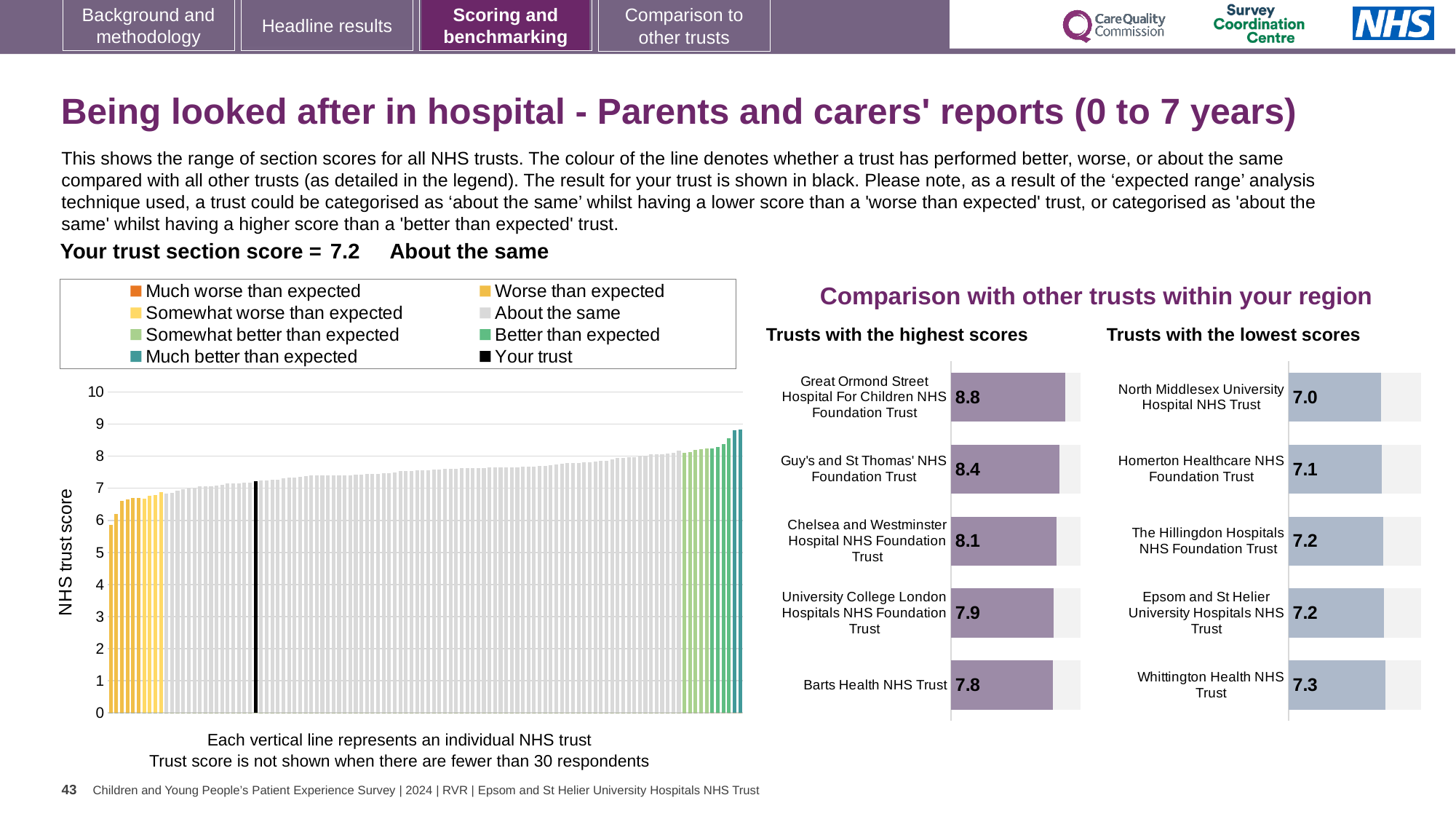
In the 'Trusts with the highest scores' chart, what is the score for Great Ormond Street Hospital For Children NHS Foundation Trust? 8.8 In the 'Trusts with the lowest scores' chart, which has the larger score: Whittington Health NHS Trust or North Middlesex University Hospital NHS Trust? Whittington Health NHS Trust What kind of chart is the large chart on the left showing NHS trust scores? Bar chart In the 'Trusts with the lowest scores' chart, what is the difference between the scores of Whittington Health NHS Trust and North Middlesex University Hospital NHS Trust? 0.3 In the 'Trusts with the highest scores' chart, what is the difference between the scores of Great Ormond Street Hospital For Children NHS Foundation Trust and Barts Health NHS Trust? 1.0 In the 'Trusts with the lowest scores' chart, which trust has the lowest score? North Middlesex University Hospital NHS Trust In the 'Trusts with the highest scores' chart, how many trusts are shown? 5 In the 'Trusts with the lowest scores' chart, which trust has the highest score? Whittington Health NHS Trust In the 'Trusts with the highest scores' chart, which trust has the lowest score? Barts Health NHS Trust In the 'Trusts with the lowest scores' chart, what is the score for Homerton Healthcare NHS Foundation Trust? 7.1 How many entries does the legend of the large chart on the left list? 8 In the large chart on the left, do the trust scores rise or fall from left to right? Rise